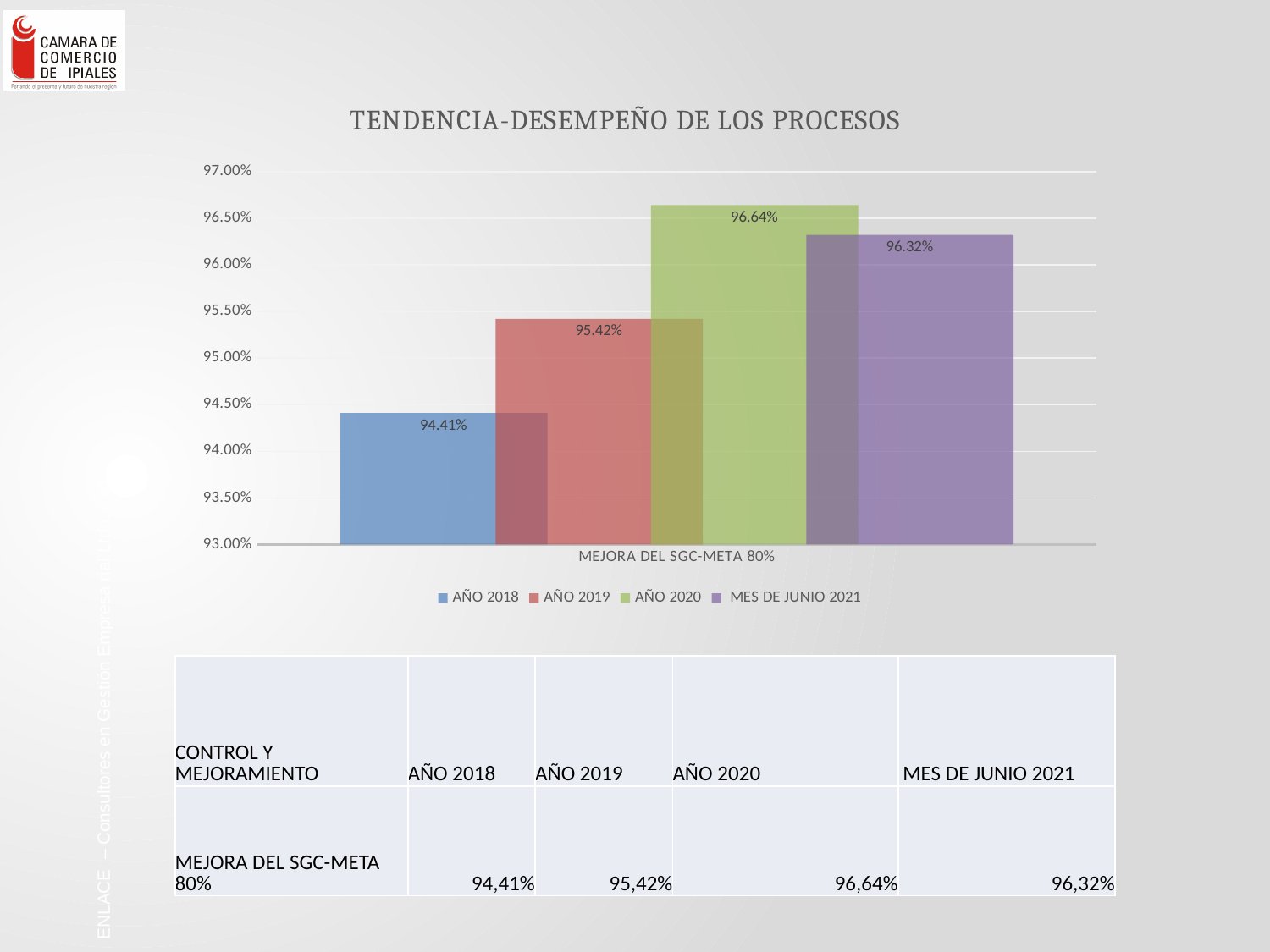
What is the value for MES DE JUNIO 2021 in the chart? 96.32% What is the title of the chart? TENDENCIA-DESEMPEÑO DE LOS PROCESOS How many series does the legend list? 4 What is the difference between the AÑO 2020 value and the AÑO 2018 value? 2.23 percentage points What is the value for AÑO 2019 in the chart? 95.42% Which series has the highest value in the chart? AÑO 2020 What is the difference between the AÑO 2020 value and the MES DE JUNIO 2021 value? 0.32 percentage points What is the value for AÑO 2018 in the chart? 94.41% Which is larger, the value for AÑO 2019 or the value for MES DE JUNIO 2021? MES DE JUNIO 2021 What kind of chart is shown on the slide? Bar chart What is the value for AÑO 2020 in the chart? 96.64% Which series has the lowest value in the chart? AÑO 2018